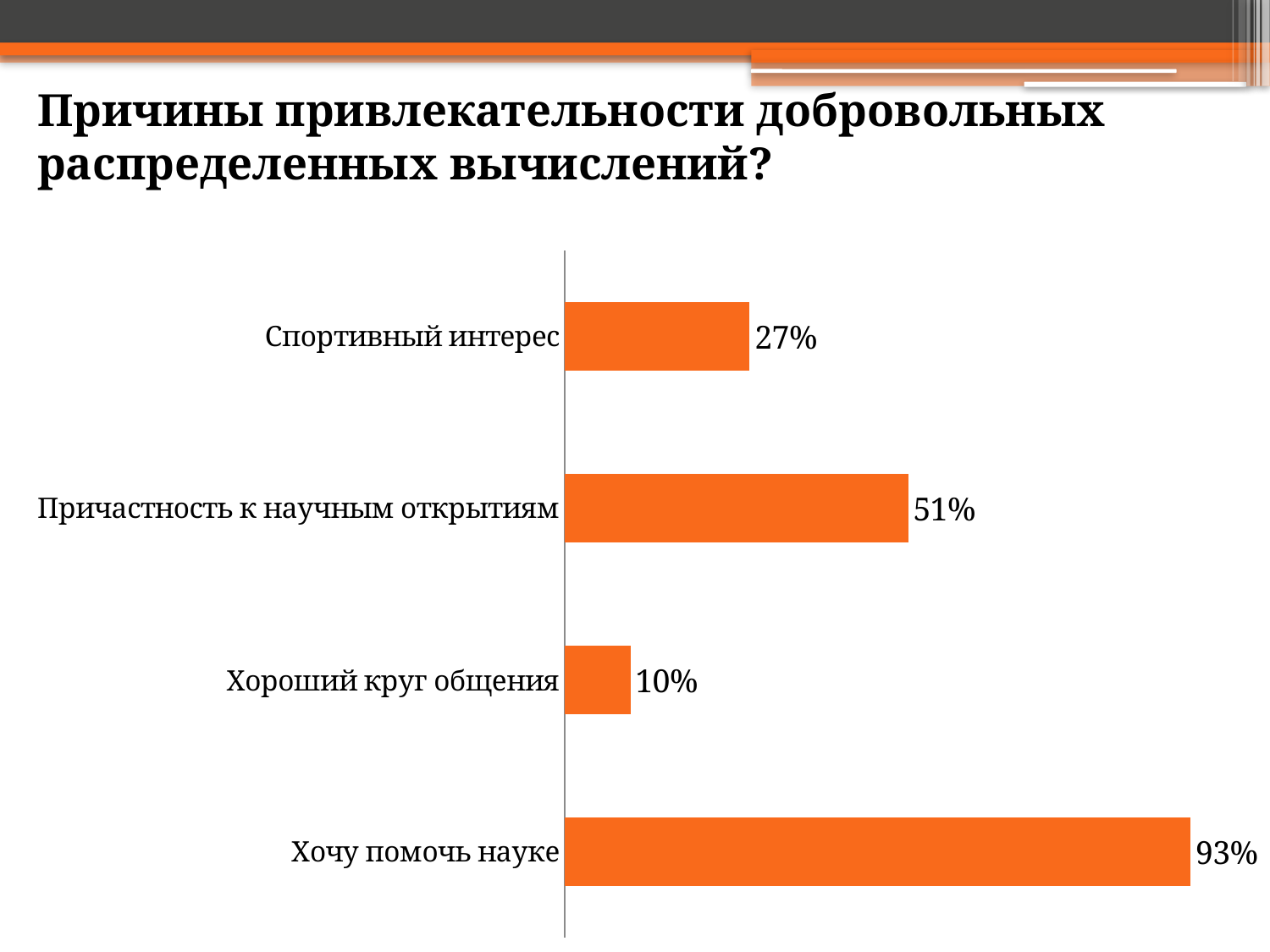
What is the value for Спортивный интерес? 27% What is the value for Хочу помочь науке? 93% What is the value for Хороший круг общения? 10% What is the difference between the values for Хочу помочь науке and Причастность к научным открытиям? 42% What colour are the bars in the chart? Orange What is the difference between the values for Спортивный интерес and Хороший круг общения? 17% Which category has the lowest value? Хороший круг общения How many categories are shown in the chart? 4 What kind of chart is shown on the slide? Bar chart Which is larger, the value for Спортивный интерес or the value for Причастность к научным открытиям? Причастность к научным открытиям What is the value for Причастность к научным открытиям? 51% Which category has the highest value? Хочу помочь науке